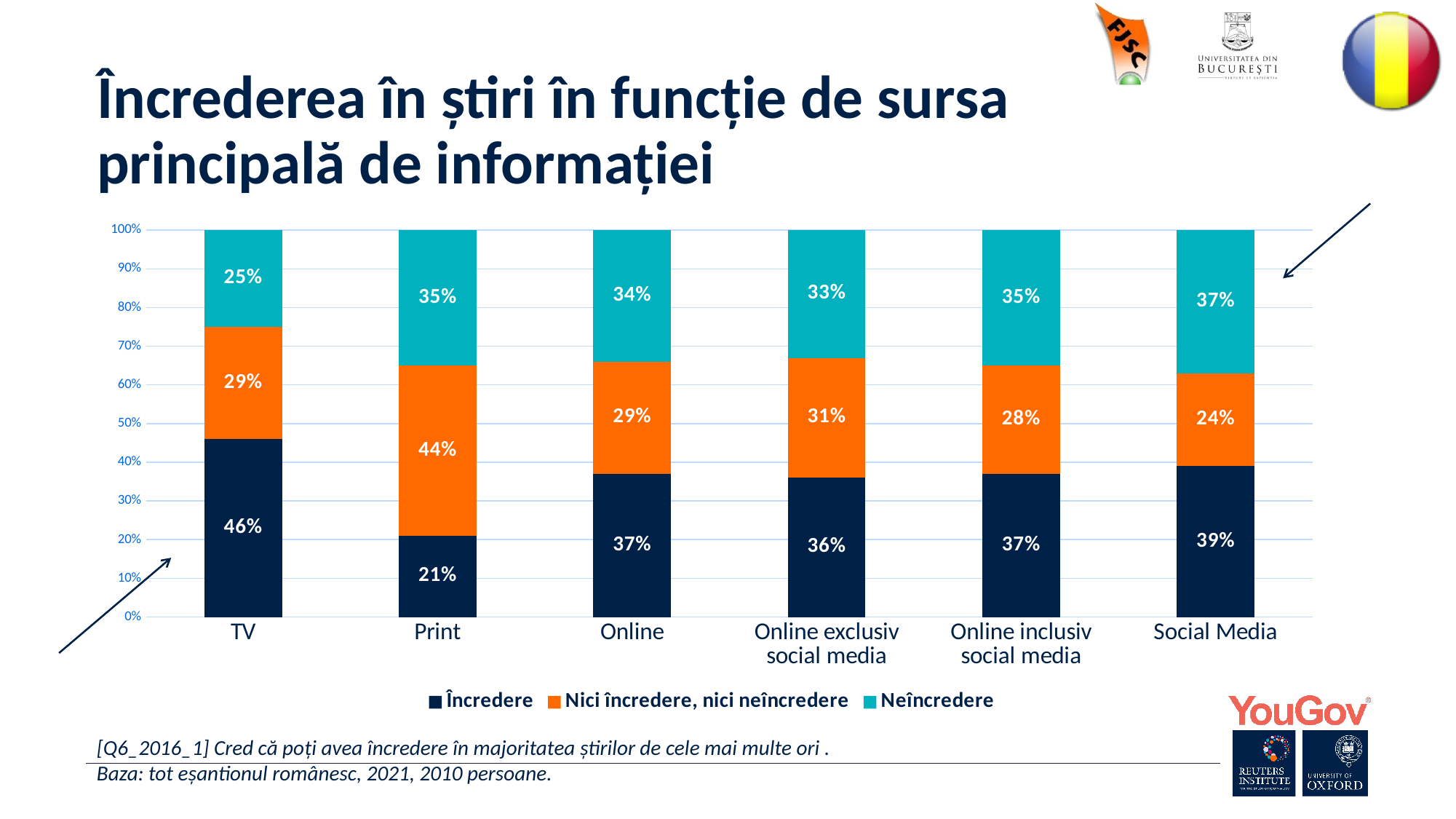
What is the difference between the Încredere values for TV and Print? 25% Which is larger: the Neîncredere value for Social Media or for Online? Social Media Which category has the lowest Încredere value? Print What is the Neîncredere value for Social Media? 37% How many categories are shown on the x axis? 6 Which category has the highest Încredere value? TV What is the 'Nici încredere, nici neîncredere' value for Print? 44% Which category has the lowest Neîncredere value? TV How many series does the legend list? 3 What kind of chart is shown on the slide? Stacked bar chart Which legend entry is shown in orange? Nici încredere, nici neîncredere What is the Încredere value for TV? 46%